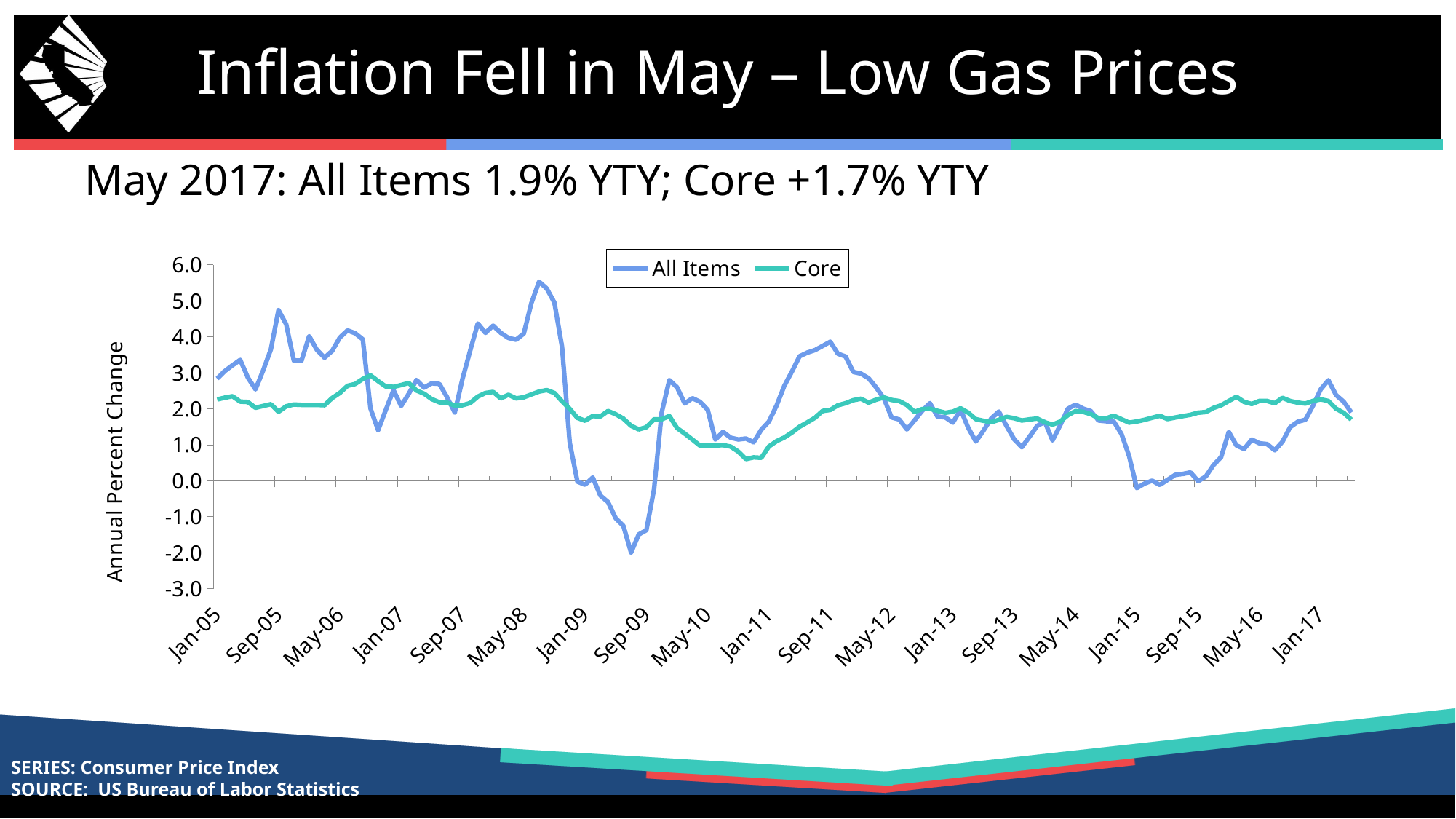
Is the lowest value of the All Items line greater or less than -1.0? less By how much does the May 2017 All Items value exceed the May 2017 Core value? 0.2 What is the All Items year-over-year value for May 2017? 1.9% What kind of chart is shown on the slide? line chart In May 2017, which is larger: the All Items value or the Core value? All Items Which series reaches the lowest value anywhere on the chart? All Items What are the two series named in the chart's legend? All Items and Core What is the Core year-over-year value for May 2017? +1.7% What is the title of the chart's vertical axis? Annual Percent Change How many series does the chart's legend list? 2 Is the lowest value of the Core line greater or less than 0.0? greater Which series reaches the highest value anywhere on the chart? All Items